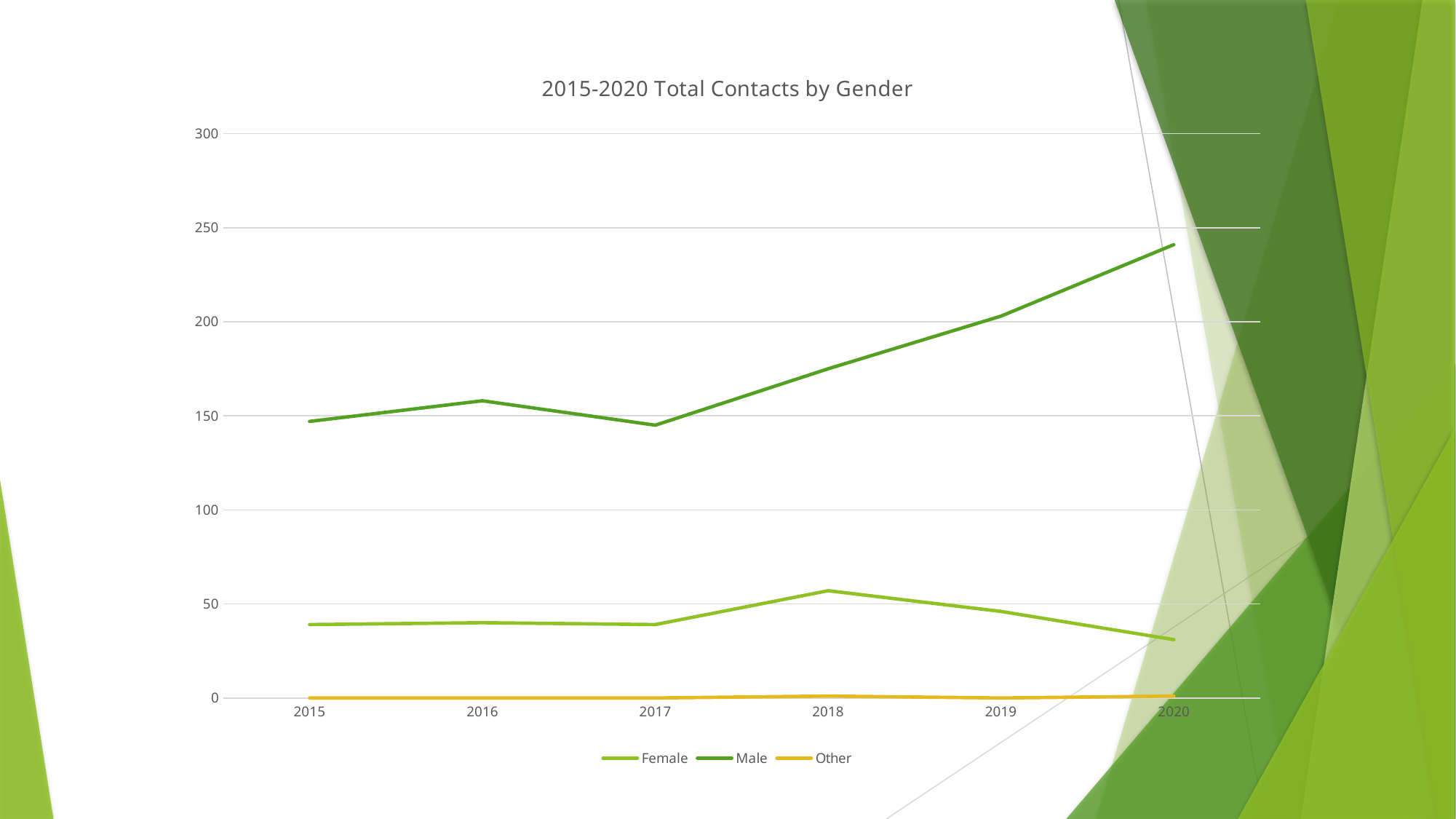
Does the Male series rise or fall from 2017 to 2020? Rise In which year does the Female series reach its highest value? 2018 Which series has the larger value in 2020, Male or Female? Male Is the value for Female in 2020 greater or less than 50? less Is the value for Male in 2018 greater or less than 150? greater Is the value for Male in 2020 greater or less than 200? greater What is the title of the chart? 2015-2020 Total Contacts by Gender How many series does the legend list? 3 What kind of chart is shown on the slide? Line chart How many years are plotted along the x axis? 6 In which year is the Female series at its lowest value? 2020 In which year does the Male series reach its highest value? 2020